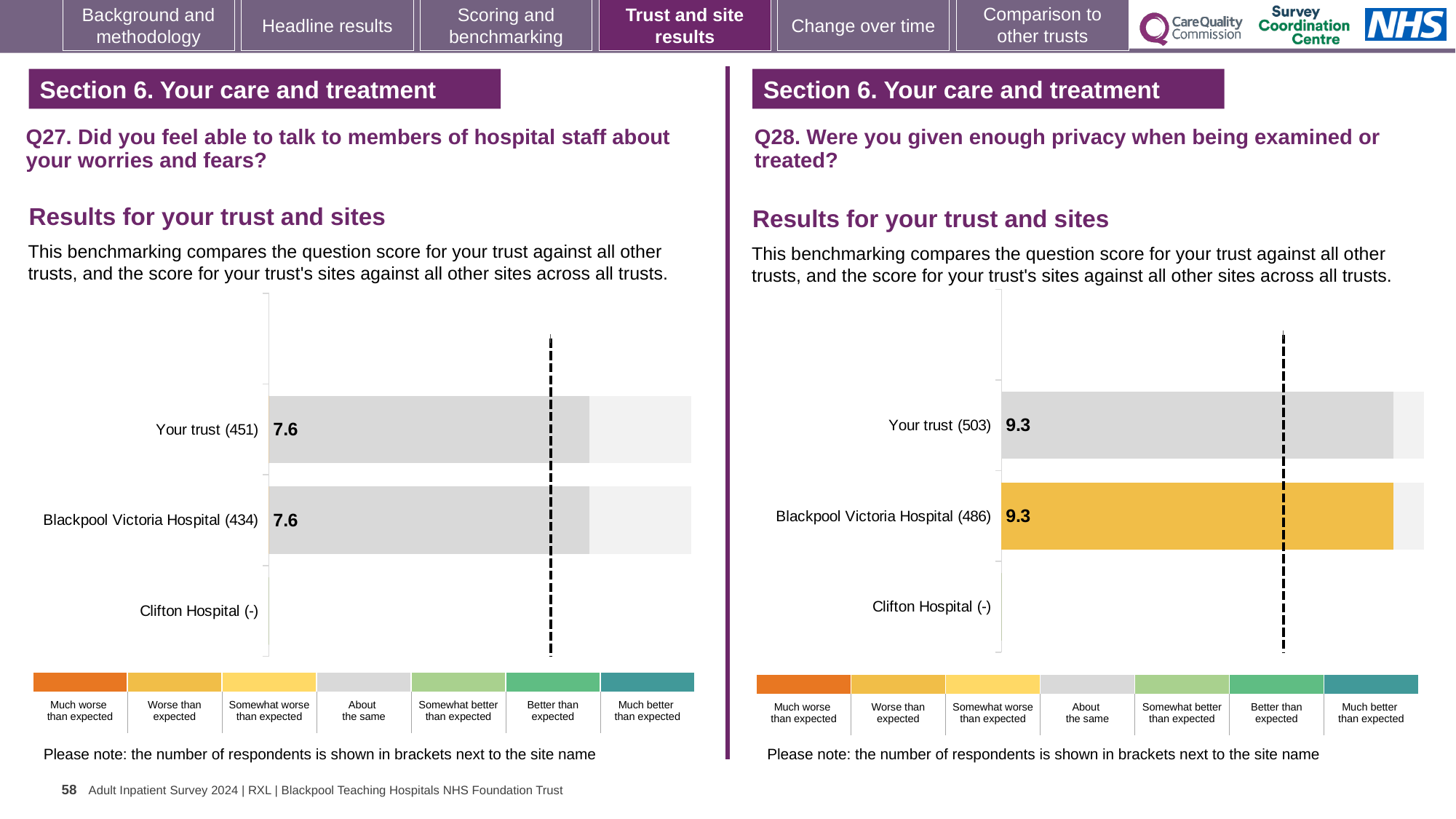
How many categories are listed on the Q27 chart (left)? 3 On the Q28 chart (right), how many respondents are shown in brackets for Blackpool Victoria Hospital? 486 How many categories are listed on the Q28 chart (right)? 3 On the Q27 chart (left), what is the difference between the score for Your trust and the score for Blackpool Victoria Hospital? 0 On the Q28 chart (right), what is the score for Blackpool Victoria Hospital? 9.3 On the Q28 chart (right), what is the score for Your trust? 9.3 On the Q27 chart (left), what is the score for Your trust? 7.6 What kind of chart is the Q28 chart (right)? Bar chart On the Q27 chart (left), what is the score for Blackpool Victoria Hospital? 7.6 On the Q28 chart (right), what is the difference between the score for Your trust and the score for Blackpool Victoria Hospital? 0 On the Q27 chart (left), how many respondents are shown in brackets for Your trust? 451 On the Q28 chart (right), which category has no score shown? Clifton Hospital (-)